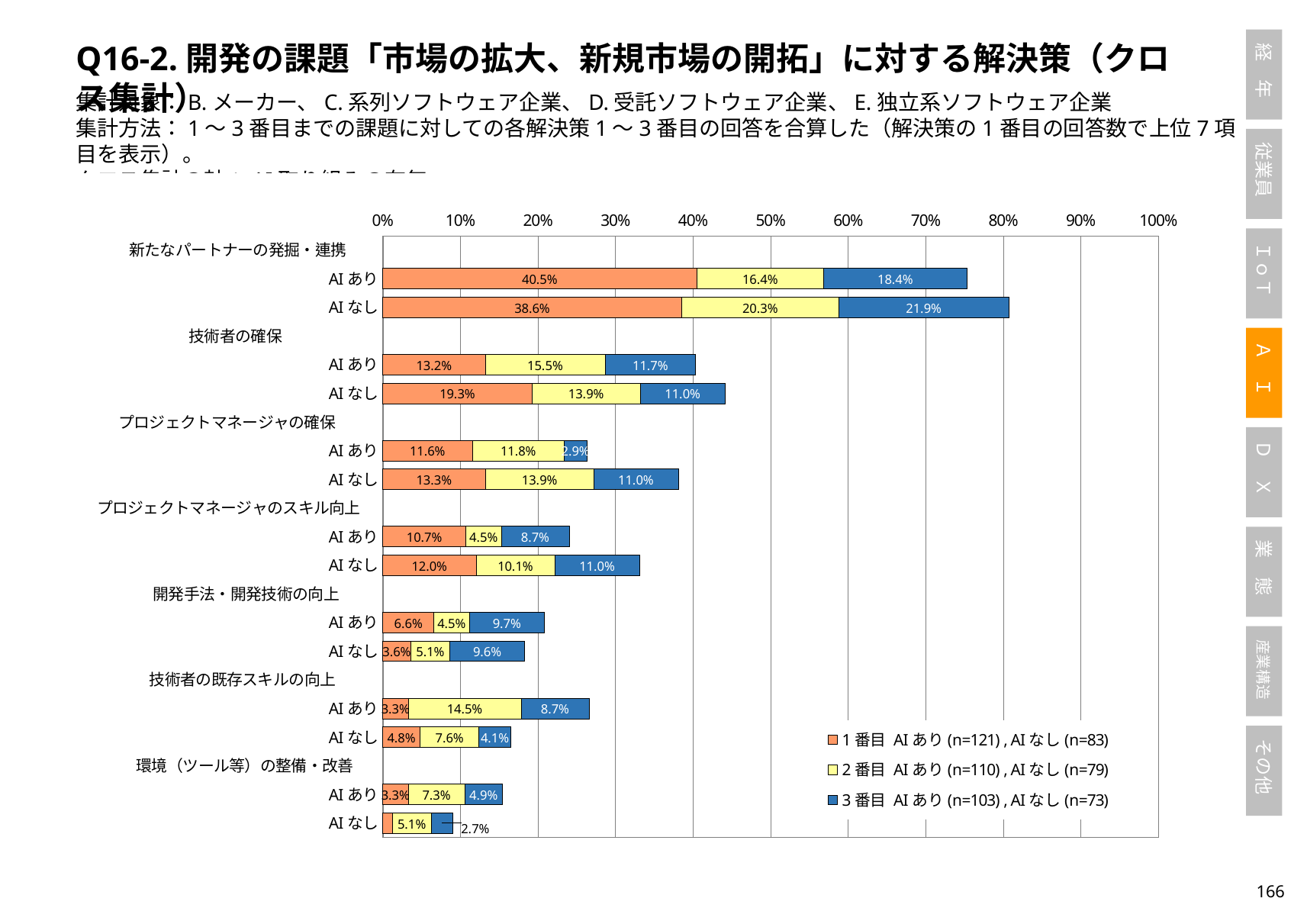
Which solution category has the longest total bar for AIなし? 新たなパートナーの発掘・連携 What is the 1番目 value for AIあり under 新たなパートナーの発掘・連携? 40.5% How many solution categories (excluding the AIあり/AIなし sub-rows) are shown on the chart? 7 What is the 2番目 value for AIあり under 技術者の既存スキルの向上? 14.5% How many series does the legend list? 3 What is the 3番目 value for AIなし under 新たなパートナーの発掘・連携? 21.9% Is the total stacked bar for AIなし under 新たなパートナーの発掘・連携 greater or less than 80%? greater What is the sample size (n) for AIあり in the 1番目 series according to the legend? 121 Under プロジェクトマネージャの確保, which is larger: the 3番目 value for AIあり or for AIなし? AIなし What is the difference between the 1番目 values for AIなし and AIあり under 技術者の確保? 6.1% What kind of chart is shown on the slide? stacked bar chart What is the total of the stacked bar for AIあり under 新たなパートナーの発掘・連携? 75.3%